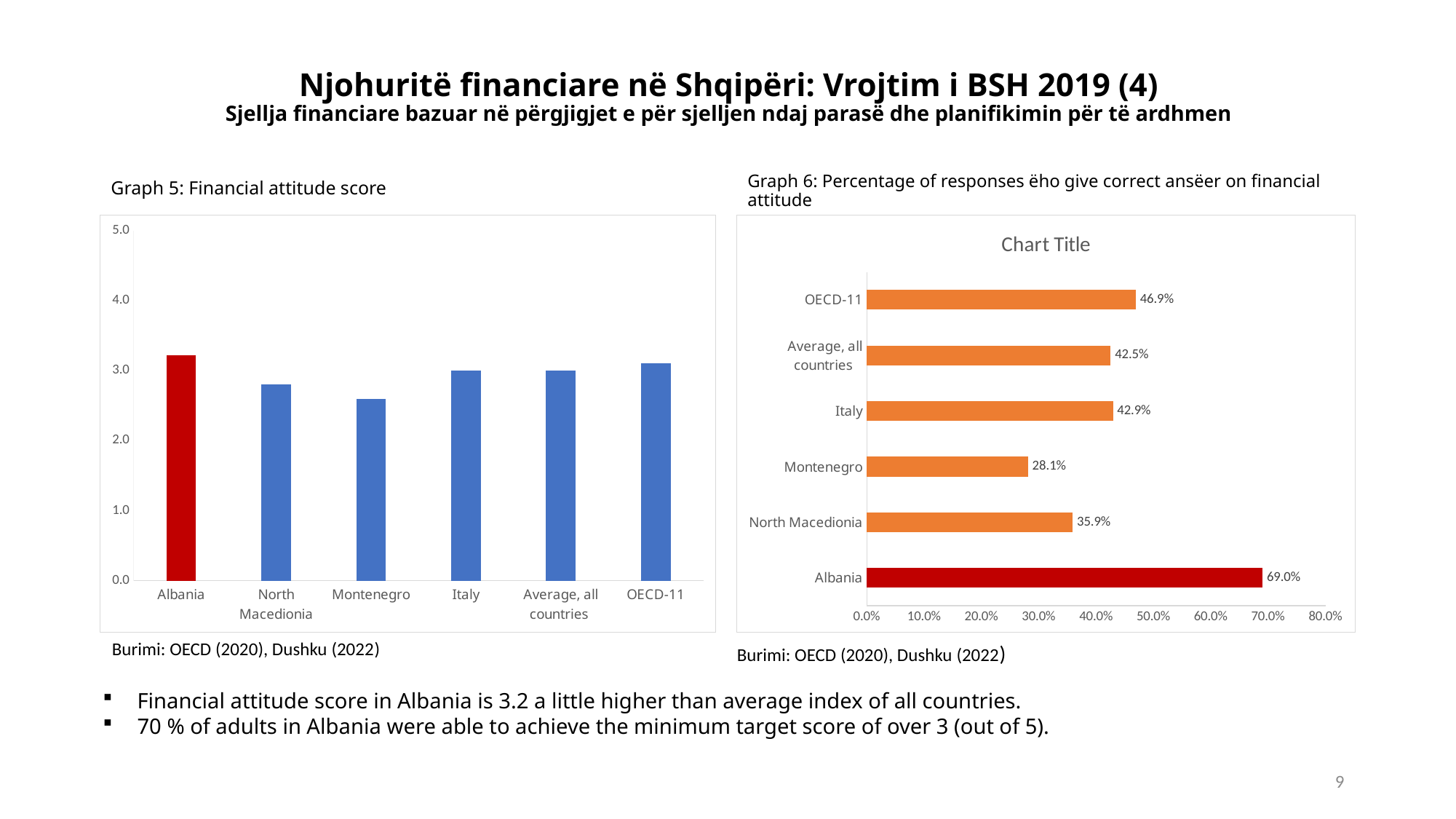
In Graph 6, which is larger, the value for Italy or the value for North Macedonia? Italy In Graph 6, what is the value for OECD-11? 46.9% In Graph 6, which category has the lowest percentage? Montenegro In Graph 6, how many categories are shown? 6 In Graph 5 (Financial attitude score), is the value for Albania greater or less than 3.0? greater In Graph 6, what is the difference between the values for Albania and OECD-11? 22.1% In Graph 6, what is the value for Montenegro? 28.1% In Graph 6, which category has the highest percentage? Albania In Graph 6 (Percentage of responses who give correct answer on financial attitude), what is the value for Albania? 69.0% In Graph 5 (Financial attitude score), is the value for Montenegro greater or less than 3.0? less What type of chart is Graph 5 (Financial attitude score)? Bar chart In Graph 5 (Financial attitude score), which category has the lowest score? Montenegro